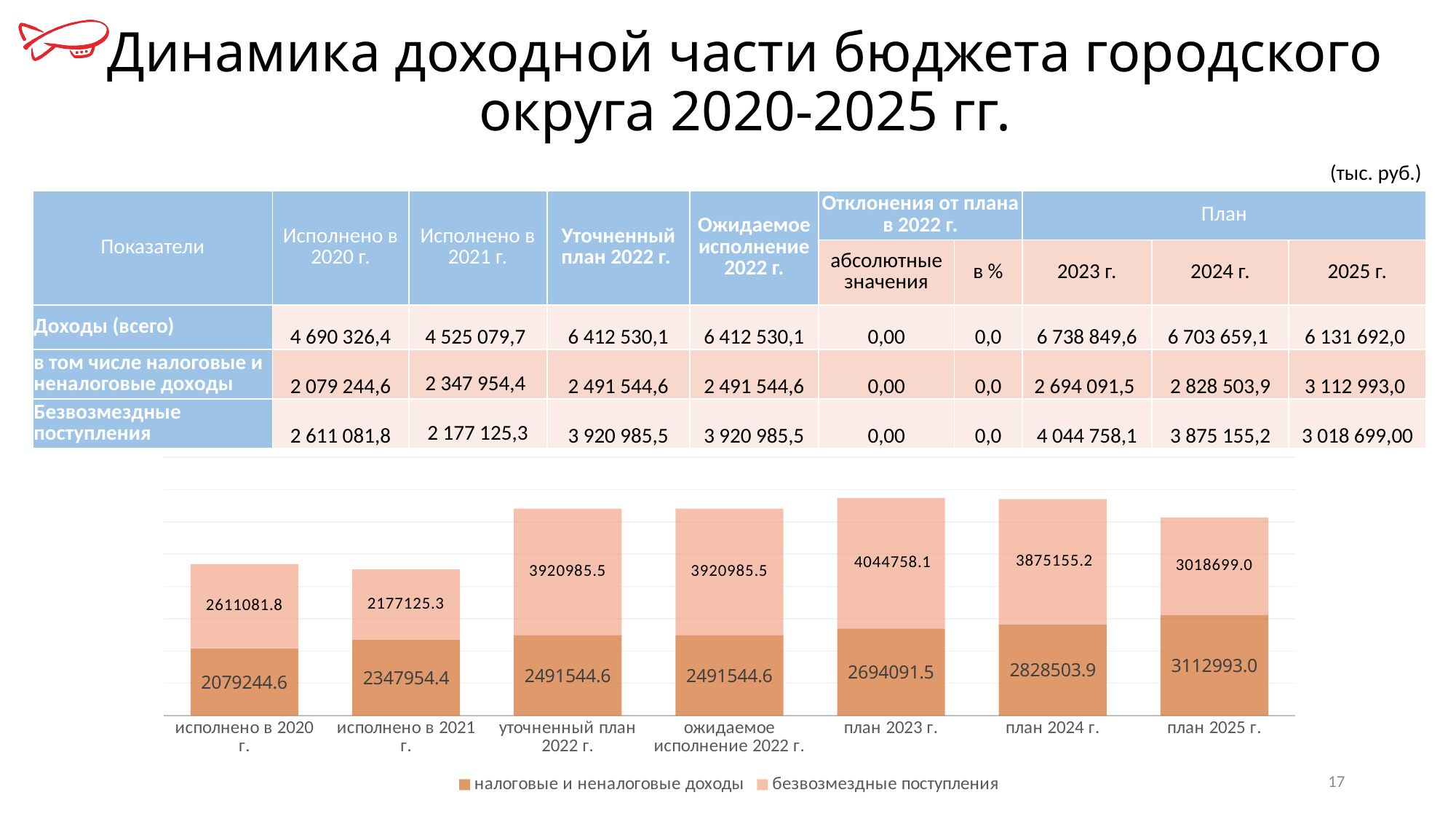
How many series does the chart legend list? 2 What is the difference between налоговые и неналоговые доходы for план 2024 г. and план 2023 г.? 134412.4 What kind of chart is shown on the slide? stacked bar chart How many categories are shown along the x axis of the chart? 7 What is the total of the stacked bar for исполнено в 2020 г.? 4690326.4 Do the values for налоговые и неналоговые доходы rise or fall from исполнено в 2020 г. to план 2025 г.? rise Which is larger for план 2025 г.: налоговые и неналоговые доходы or безвозмездные поступления? налоговые и неналоговые доходы What is the value of безвозмездные поступления for исполнено в 2021 г.? 2177125.3 Which category has the highest value for безвозмездные поступления? план 2023 г. Which category has the highest value for налоговые и неналоговые доходы? план 2025 г. Which category has the lowest value for безвозмездные поступления? исполнено в 2021 г. What is the value of налоговые и неналоговые доходы for план 2024 г.? 2828503.9